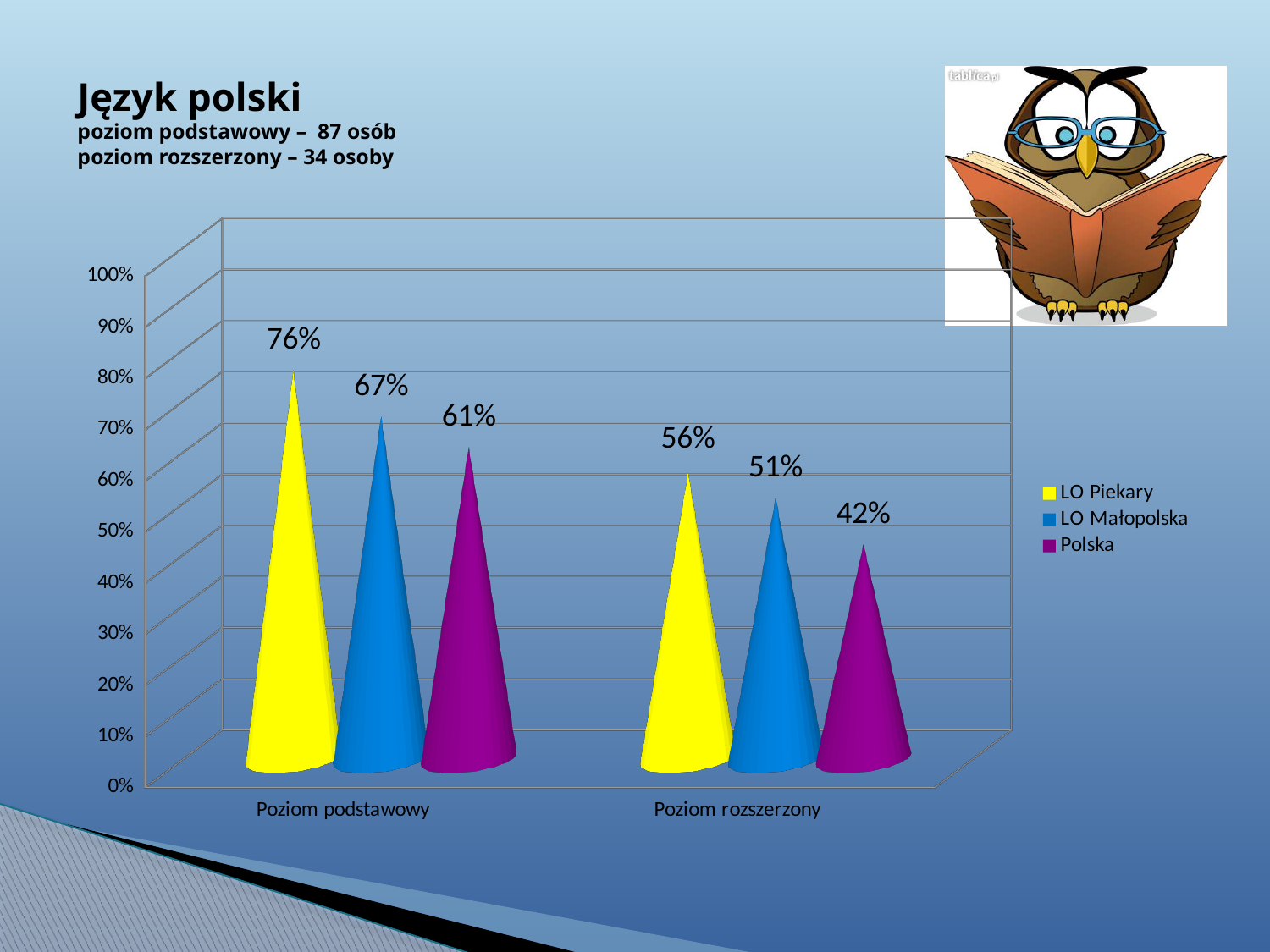
What is the difference between the LO Piekary and Polska values in the Poziom podstawowy category? 15% How many categories are shown on the x axis? 2 Which series has the lowest value in the Poziom rozszerzony category? Polska How many series does the legend list? 3 What is the value for LO Piekary in the Poziom podstawowy category? 76% Which colour represents Polska in the legend? Purple What is the value for Polska in the Poziom rozszerzony category? 42% What is the value for LO Małopolska in the Poziom rozszerzony category? 51% Which is larger: LO Małopolska for Poziom podstawowy or LO Piekary for Poziom rozszerzony? LO Małopolska for Poziom podstawowy Which series has the highest value in the Poziom podstawowy category? LO Piekary What is the difference between the LO Piekary values for Poziom podstawowy and Poziom rozszerzony? 20% What kind of chart is shown on the slide? Bar chart